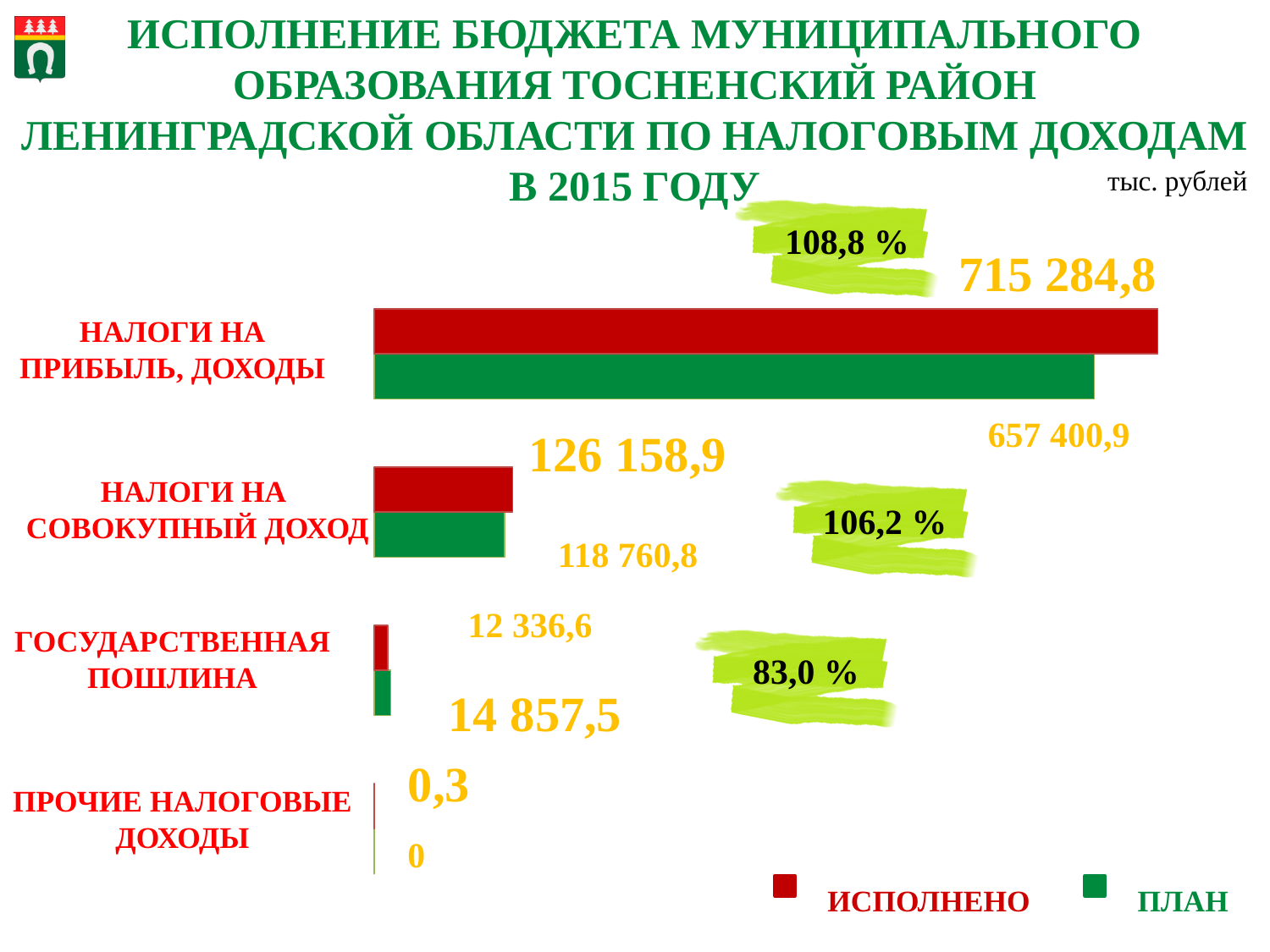
What execution percentage is shown for ГОСУДАРСТВЕННАЯ ПОШЛИНА? 83,0 % What is the ИСПОЛНЕНО value for НАЛОГИ НА СОВОКУПНЫЙ ДОХОД? 126 158,9 For ГОСУДАРСТВЕННАЯ ПОШЛИНА, which is larger: ИСПОЛНЕНО or ПЛАН? ПЛАН How many categories are shown in the chart? 4 Which category has the highest ИСПОЛНЕНО value? НАЛОГИ НА ПРИБЫЛЬ, ДОХОДЫ What is the ИСПОЛНЕНО value for ПРОЧИЕ НАЛОГОВЫЕ ДОХОДЫ? 0,3 What is the ПЛАН value for НАЛОГИ НА ПРИБЫЛЬ, ДОХОДЫ? 657 400,9 Which category has the lowest ПЛАН value? ПРОЧИЕ НАЛОГОВЫЕ ДОХОДЫ What is the difference between the ИСПОЛНЕНО and ПЛАН values for НАЛОГИ НА ПРИБЫЛЬ, ДОХОДЫ? 57 883,9 What is the ПЛАН value for ГОСУДАРСТВЕННАЯ ПОШЛИНА? 14 857,5 What is the ИСПОЛНЕНО value for НАЛОГИ НА ПРИБЫЛЬ, ДОХОДЫ? 715 284,8 How many series does the legend list? 2